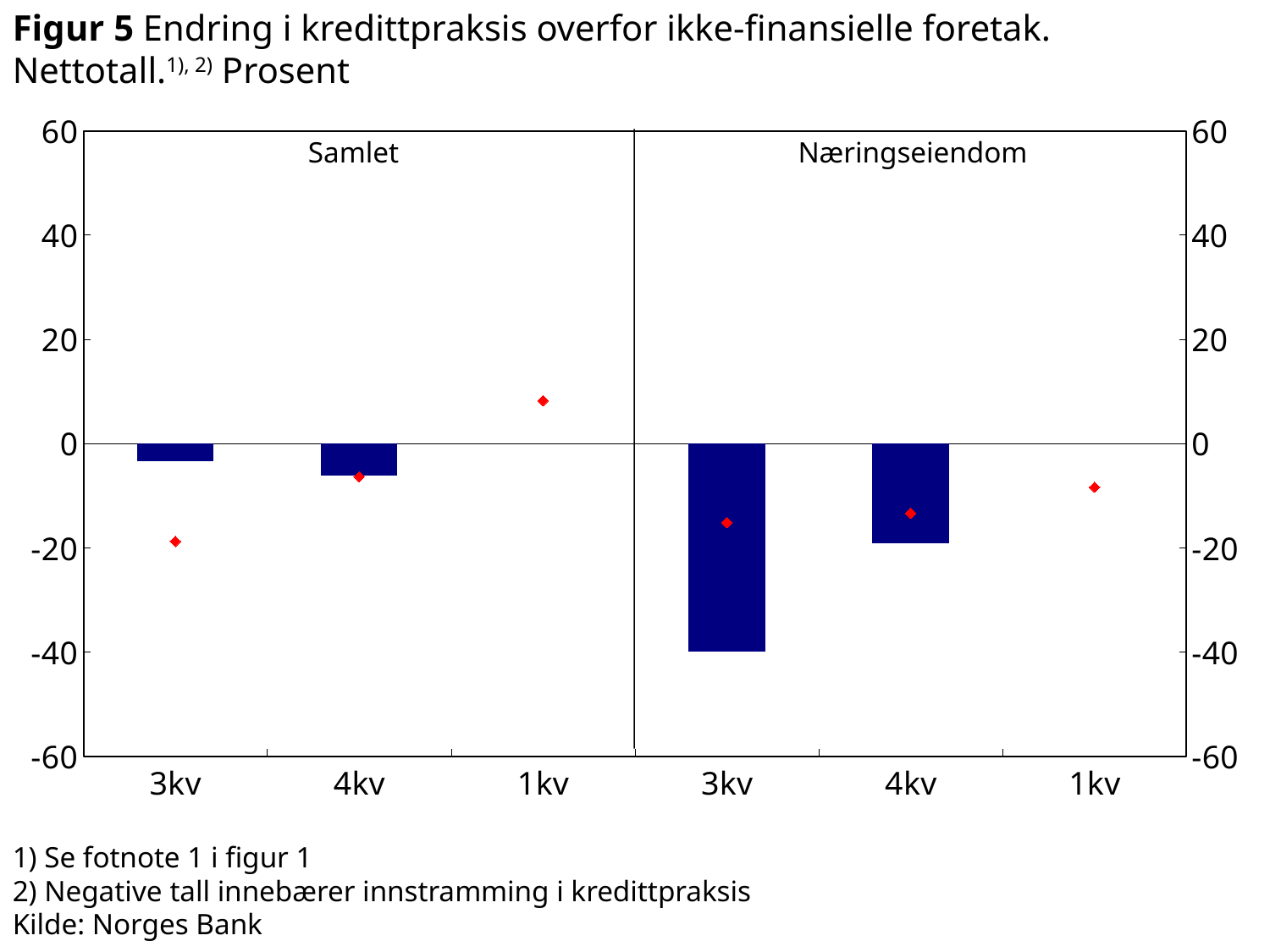
In the Samlet panel, do the red markers rise or fall from 3kv to 1kv? rise How many quarter categories are shown across both panels of the chart? 6 Which bar in the chart is the lowest? 3kv in Næringseiendom In the Næringseiendom panel, is the bar for 3kv greater or less than -20? less What are the two panel headings in the chart? Samlet and Næringseiendom In the Samlet panel, is the bar for 3kv greater or less than -20? greater In the Næringseiendom panel, which bar is lower, 3kv or 4kv? 3kv What kind of chart is shown on the slide? bar chart with red diamond markers In the Samlet panel, is the red marker for 3kv greater or less than 0? less In the Samlet panel, which bar is lower, 3kv or 4kv? 4kv What is the source given for the chart? Norges Bank